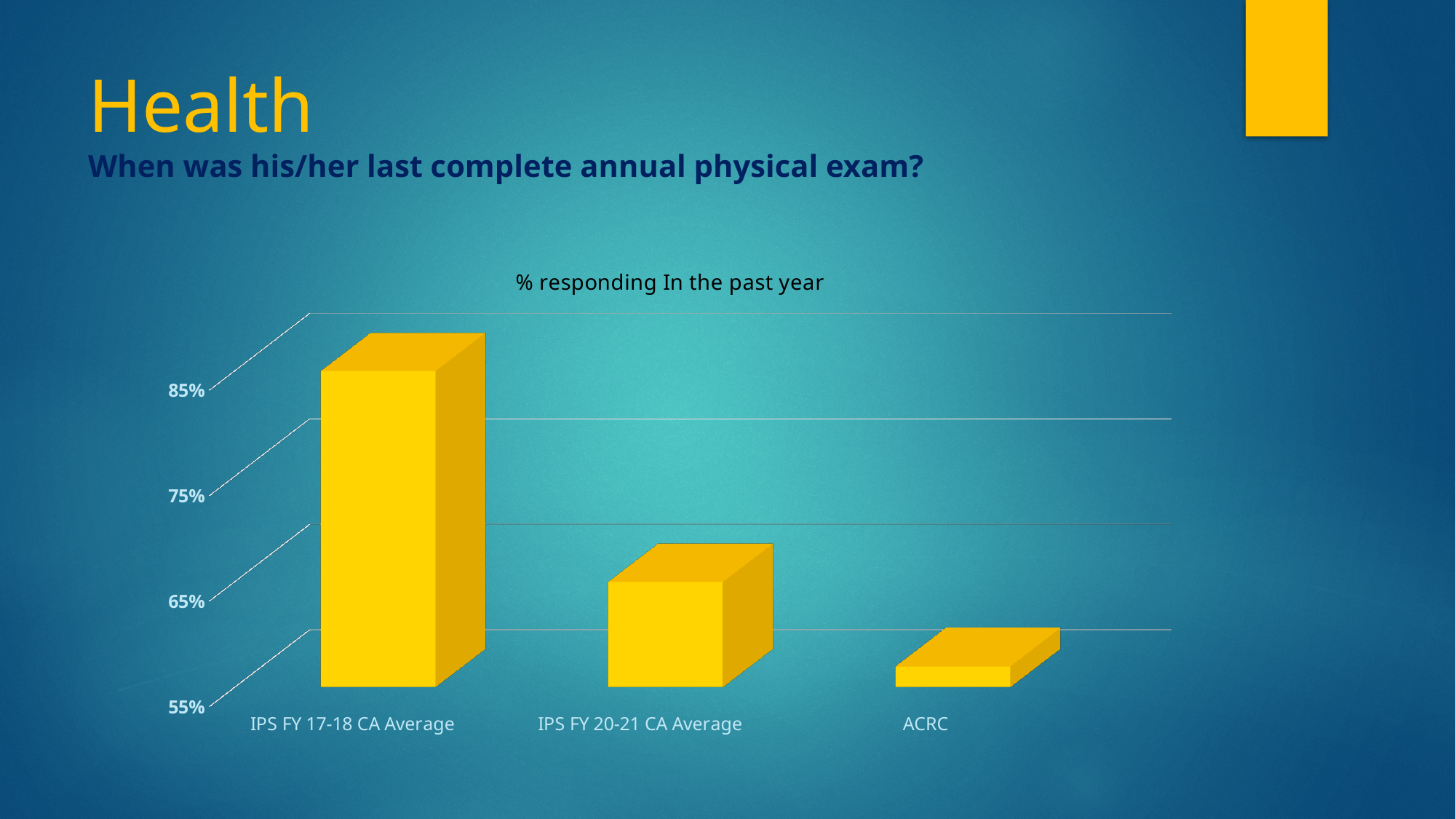
Which is larger, the value for IPS FY 20-21 CA Average or the value for ACRC? IPS FY 20-21 CA Average What kind of chart is shown on the slide? bar chart How many categories are plotted in the chart? 3 What colour are the bars in the chart? yellow Which category has the highest value? IPS FY 17-18 CA Average Is the value for ACRC greater or less than 65%? less Which category has the lowest value? ACRC What is the title of the chart? % responding In the past year Do the values rise or fall moving from left to right across the categories? fall Which is larger, the value for IPS FY 17-18 CA Average or the value for ACRC? IPS FY 17-18 CA Average Is the value for IPS FY 17-18 CA Average greater or less than 75%? greater Is the value for IPS FY 20-21 CA Average greater or less than 75%? less